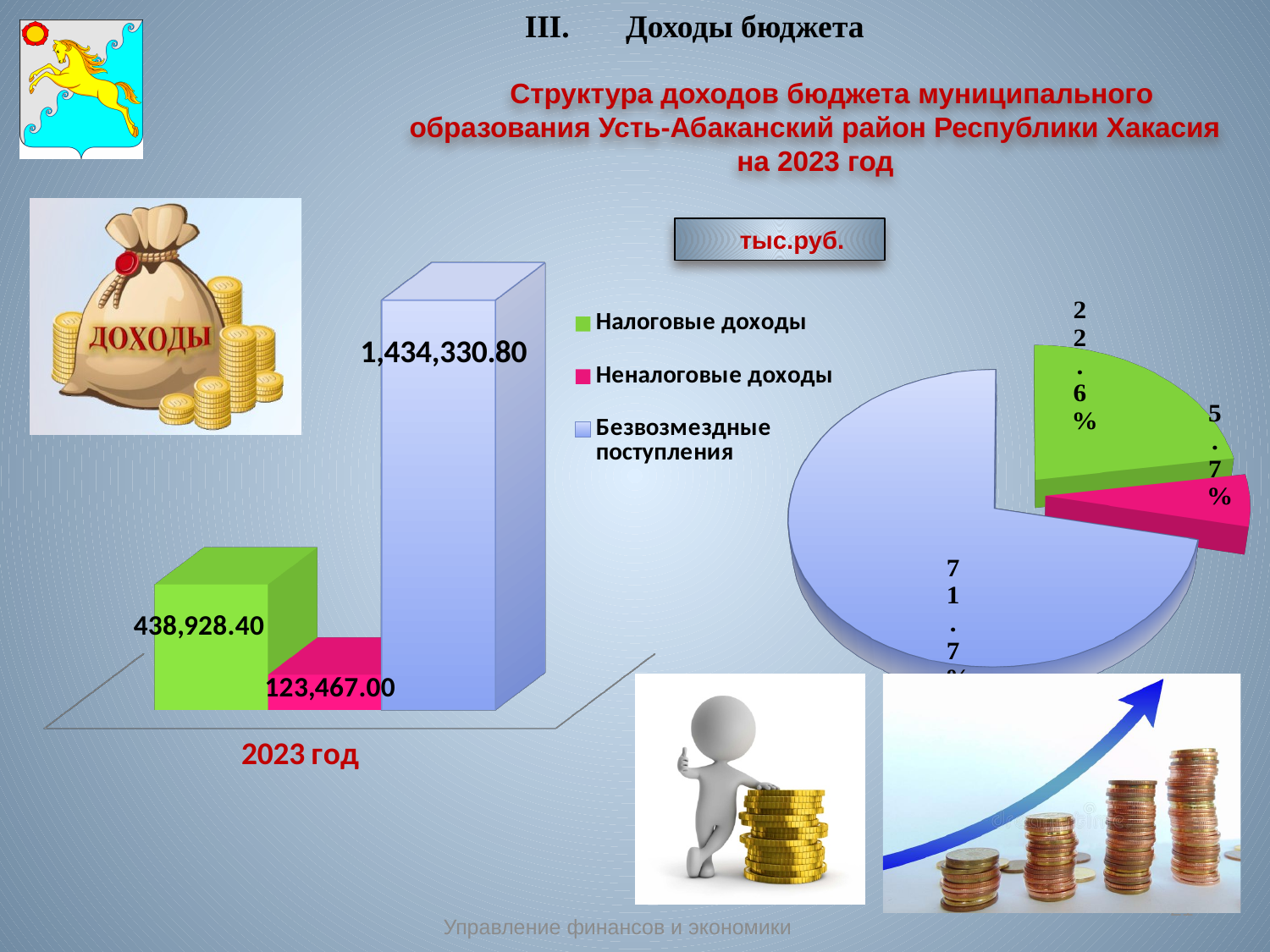
On the bar chart, which series has the lowest value? Неналоговые доходы What type of chart is shown on the right side of the slide? Pie chart On the bar chart, what is the value for Безвозмездные поступления in 2023? 1,434,330.80 On the pie chart, what share is shown for the green slice (Налоговые доходы)? 22.6% On the bar chart, which series has the highest value? Безвозмездные поступления How many series does the legend of the bar chart list? 3 On the bar chart, what is the value for Неналоговые доходы in 2023? 123,467.00 What type of chart is shown on the left side of the slide? Bar chart On the bar chart, which is larger: Налоговые доходы or Неналоговые доходы? Налоговые доходы On the bar chart, what is the value for Налоговые доходы in 2023? 438,928.40 On the bar chart, what is the difference between Налоговые доходы and Неналоговые доходы? 315,461.40 On the pie chart, what share is shown for the pink slice (Неналоговые доходы)? 5.7%